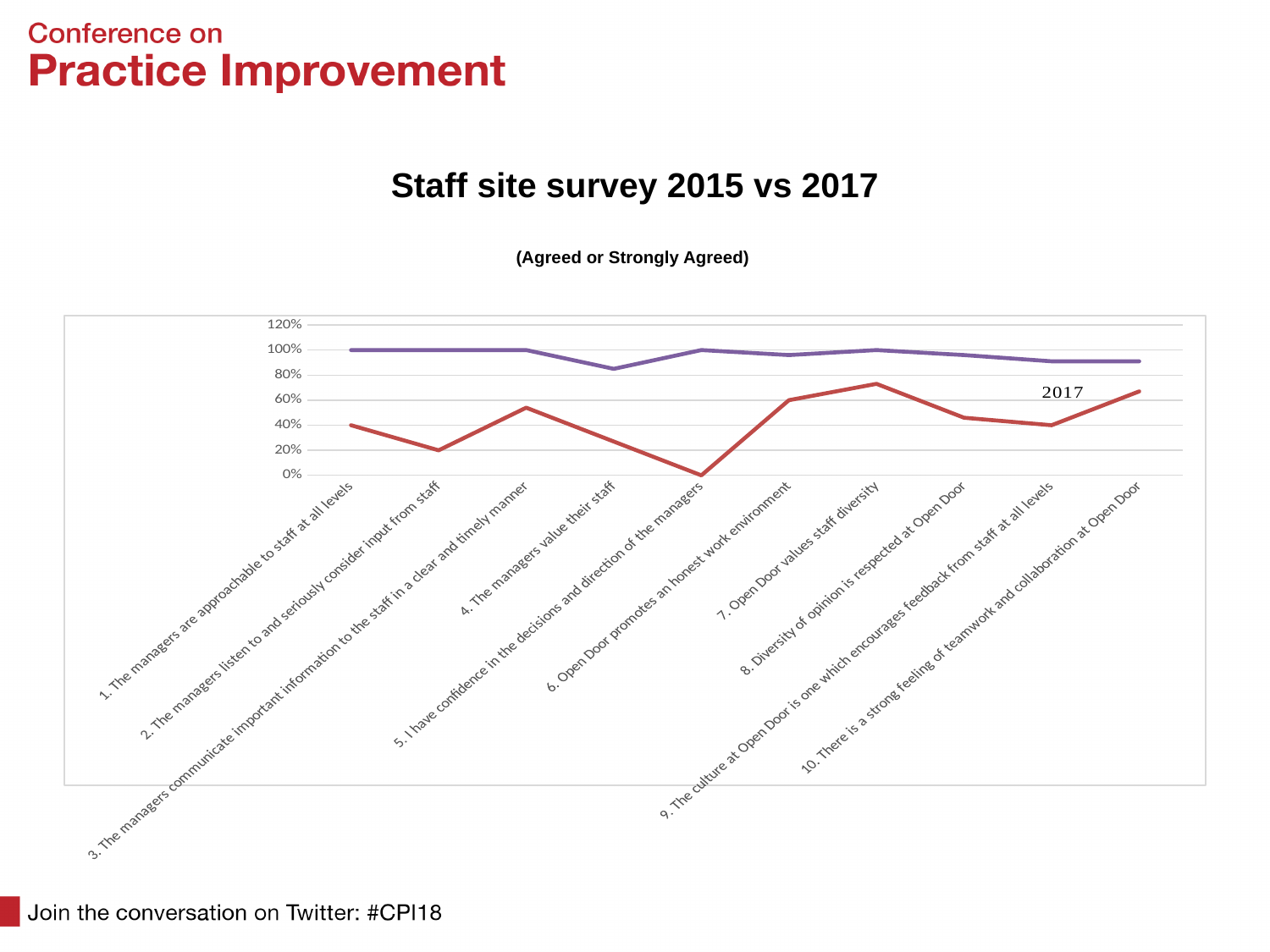
For statement 4, 'The managers value their staff', which line has the higher value, the purple (2017) line or the red line? the purple (2017) line What is the value of the purple (2017) line for statement 1, 'The managers are approachable to staff at all levels'? 100% Which year label is printed next to the purple line? 2017 For which statement is the red line at its lowest? 5. I have confidence in the decisions and direction of the managers How many survey statements (categories) are plotted along the x axis? 10 Is the value of the purple (2017) line for statement 4, 'The managers value their staff', greater or less than 100%? less What kind of chart is shown on the slide? line chart What is the title of the chart? Staff site survey 2015 vs 2017 For which statement is the red line at its highest? 7. Open Door values staff diversity What is the value of the red line for statement 5, 'I have confidence in the decisions and direction of the managers'? 0% What is the value of the red line for statement 1, 'The managers are approachable to staff at all levels'? 40% Is the value of the red line for statement 7, 'Open Door values staff diversity', greater or less than 60%? greater